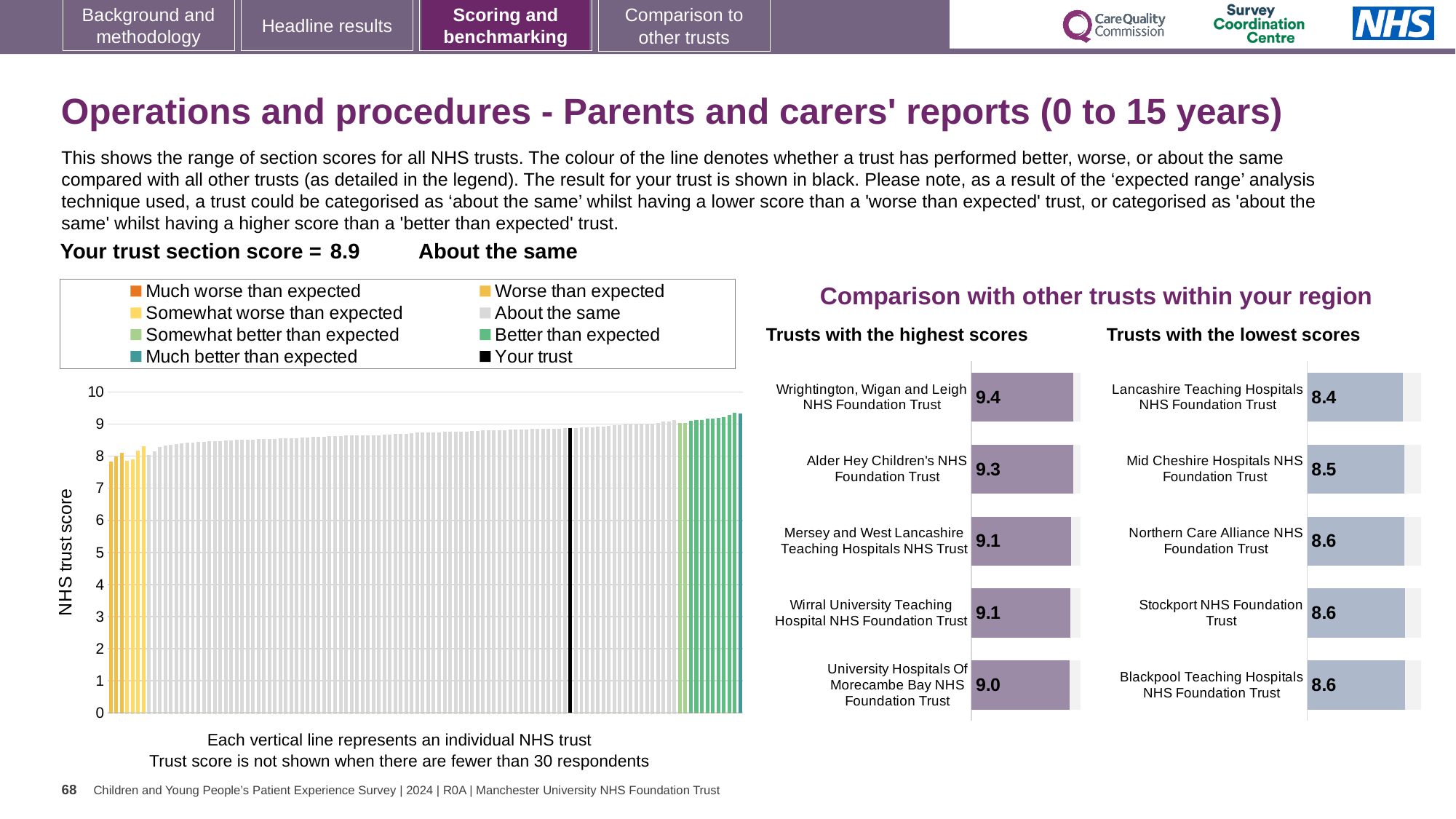
How many trusts are listed in the 'Trusts with the highest scores' chart? 5 In the main NHS trust score chart, do the bars rise or fall from left to right? Rise What kind of chart is the main chart on the left showing NHS trust scores? Bar chart Which has the higher score: Alder Hey Children's NHS Foundation Trust in the highest scores chart or Mid Cheshire Hospitals NHS Foundation Trust in the lowest scores chart? Alder Hey Children's NHS Foundation Trust In the main NHS trust score chart, is the value of the rightmost bar greater or less than 9? greater In the 'Trusts with the highest scores' chart, what is the difference between the scores of Wrightington, Wigan and Leigh NHS Foundation Trust and University Hospitals Of Morecambe Bay NHS Foundation Trust? 0.4 How many entries does the legend of the main NHS trust score chart list? 8 In the 'Trusts with the highest scores' chart, what is the score for Wrightington, Wigan and Leigh NHS Foundation Trust? 9.4 In the 'Trusts with the lowest scores' chart, which trust has the lowest score? Lancashire Teaching Hospitals NHS Foundation Trust What is the y-axis label of the main chart on the left? NHS trust score In the 'Trusts with the highest scores' chart, which trust has the highest score? Wrightington, Wigan and Leigh NHS Foundation Trust In the 'Trusts with the lowest scores' chart, what is the score for Lancashire Teaching Hospitals NHS Foundation Trust? 8.4